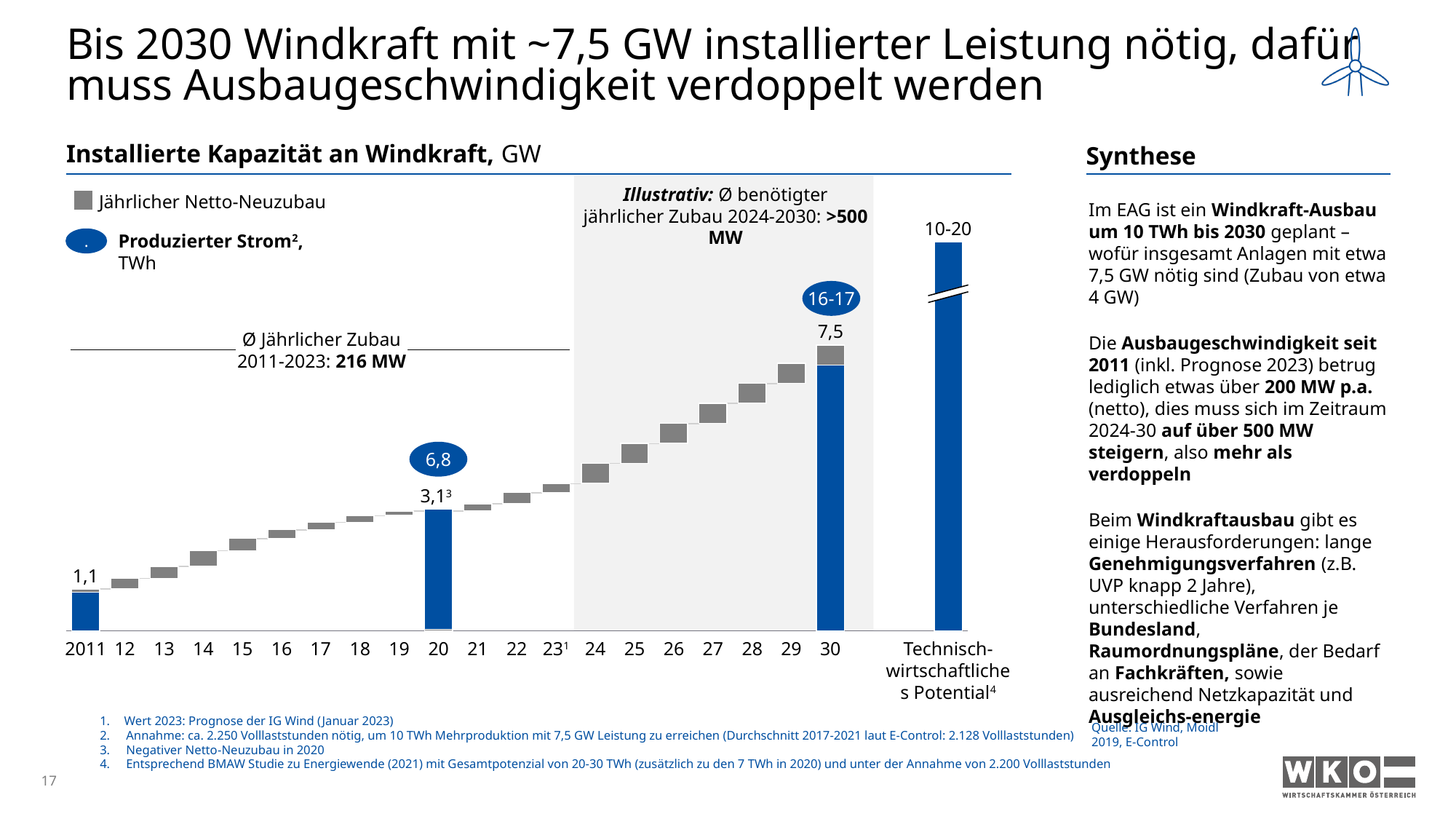
What is the installed wind capacity shown for 2011? 1,1 What average annual addition (Ø Jährlicher Zubau) is stated for 2011-2023? 216 MW What is the produced electricity (Produzierter Strom, TWh) shown for 2030? 16-17 By how much does the installed capacity in 2030 exceed that of 2020? 4,4 What is the installed wind capacity shown for 2030? 7,5 How many entries does the chart legend list? 2 What value is shown for the 'Technisch-wirtschaftliches Potential' bar? 10-20 Which year has the higher installed capacity, 2011 or 2020? 2020 What is the produced electricity (Produzierter Strom, TWh) shown for 2020? 6,8 What kind of chart is used to show the installed wind capacity? bar chart Do the installed capacity values rise or fall from 2011 to 2030? rise What is the installed wind capacity shown for 2020? 3,1